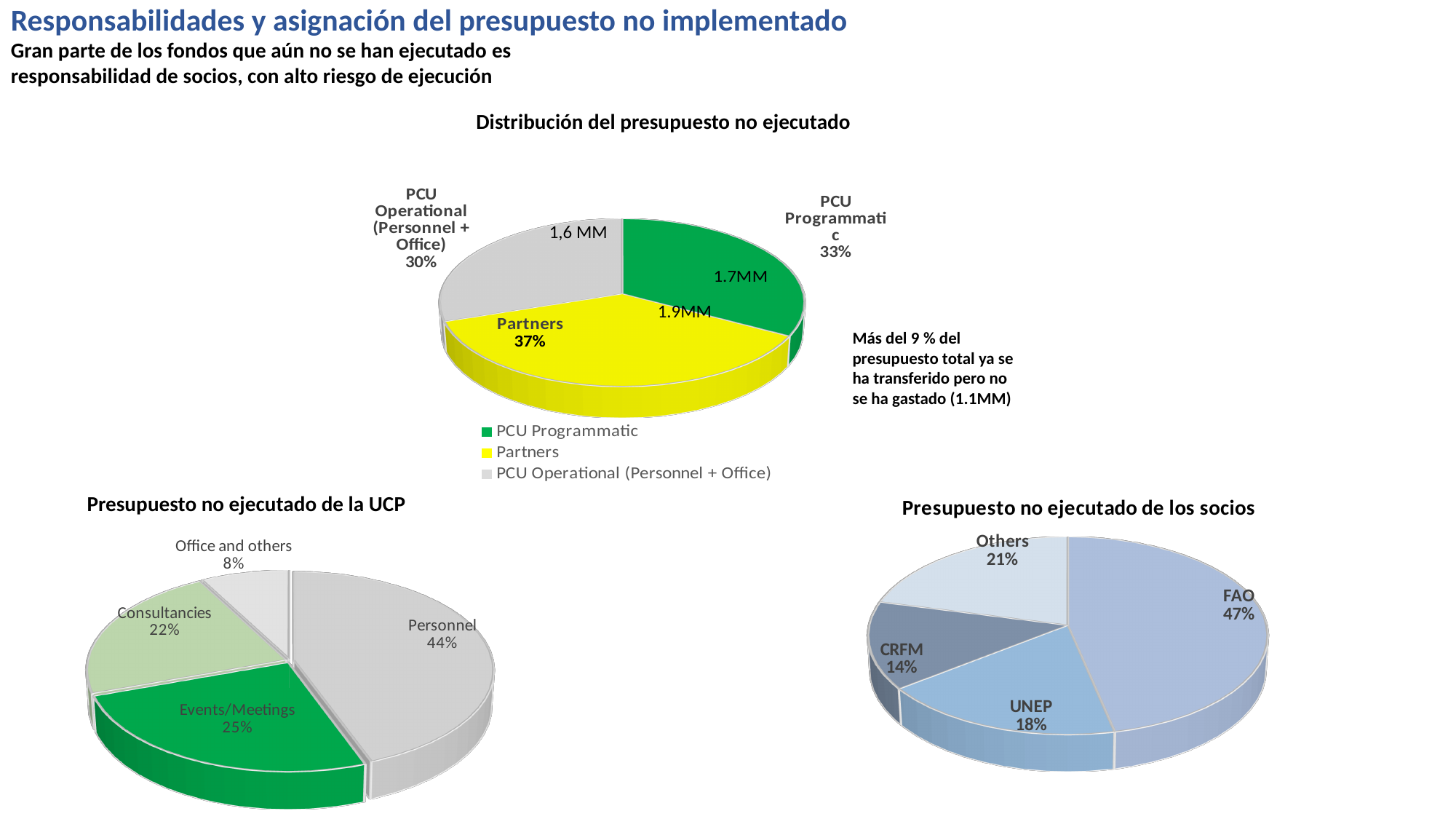
In the chart 'Presupuesto no ejecutado de la UCP', how many categories are shown? 4 In the chart 'Distribución del presupuesto no ejecutado', what share of the pie is Partners? 37% What kind of chart is 'Presupuesto no ejecutado de los socios'? Pie chart In the chart 'Presupuesto no ejecutado de la UCP', what share of the pie is Personnel? 44% In the chart 'Presupuesto no ejecutado de los socios', what share of the pie is UNEP? 18% In the chart 'Presupuesto no ejecutado de la UCP', which category has the smallest share? Office and others In the chart 'Distribución del presupuesto no ejecutado', what colour is the Partners slice? Yellow In the chart 'Distribución del presupuesto no ejecutado', what value is labelled on the PCU Programmatic slice? 1.7MM In the chart 'Presupuesto no ejecutado de la UCP', what is the difference in percentage points between Events/Meetings and Consultancies? 3 percentage points In the chart 'Distribución del presupuesto no ejecutado', how many entries does the legend list? 3 In the chart 'Distribución del presupuesto no ejecutado', which category has the largest share? Partners In the chart 'Presupuesto no ejecutado de los socios', which is larger, CRFM or Others? Others